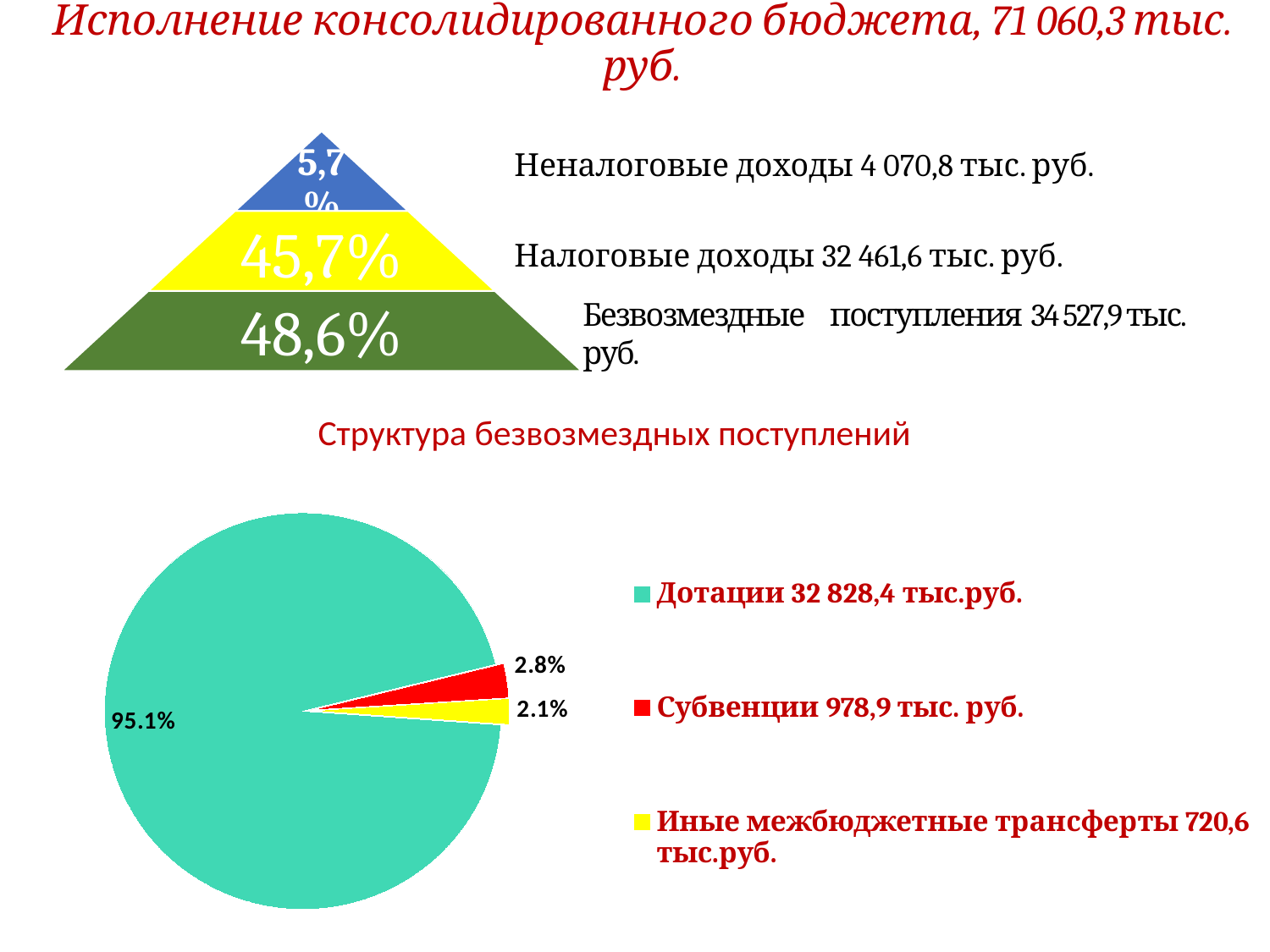
In the pie chart 'Структура безвозмездных поступлений', what share does the Субвенции slice have? 2.8% In the pyramid chart at the top of the slide, what percentage is shown for the bottom (green) layer, Безвозмездные поступления? 48,6% In the pie chart 'Структура безвозмездных поступлений', what colour is the Дотации slice? turquoise (green-blue) In the pie chart 'Структура безвозмездных поступлений', what amount does the legend give for Субвенции? 978,9 тыс. руб. In the pyramid chart at the top of the slide, which layer has the smallest percentage? Неналоговые доходы (5,7%) In the pie chart 'Структура безвозмездных поступлений', which category has the largest slice? Дотации In the pie chart 'Структура безвозмездных поступлений', what share does the Дотации slice have? 95.1% In the pie chart 'Структура безвозмездных поступлений', what is the difference in percentage points between the Субвенции and Иные межбюджетные трансферты slices? 0.7% What kind of chart is shown under the heading 'Структура безвозмездных поступлений'? pie chart In the pie chart 'Структура безвозмездных поступлений', which category has the smallest slice? Иные межбюджетные трансферты In the pie chart 'Структура безвозмездных поступлений', how many slices are there? 3 In the pie chart 'Структура безвозмездных поступлений', what share does the Иные межбюджетные трансферты slice have? 2.1%